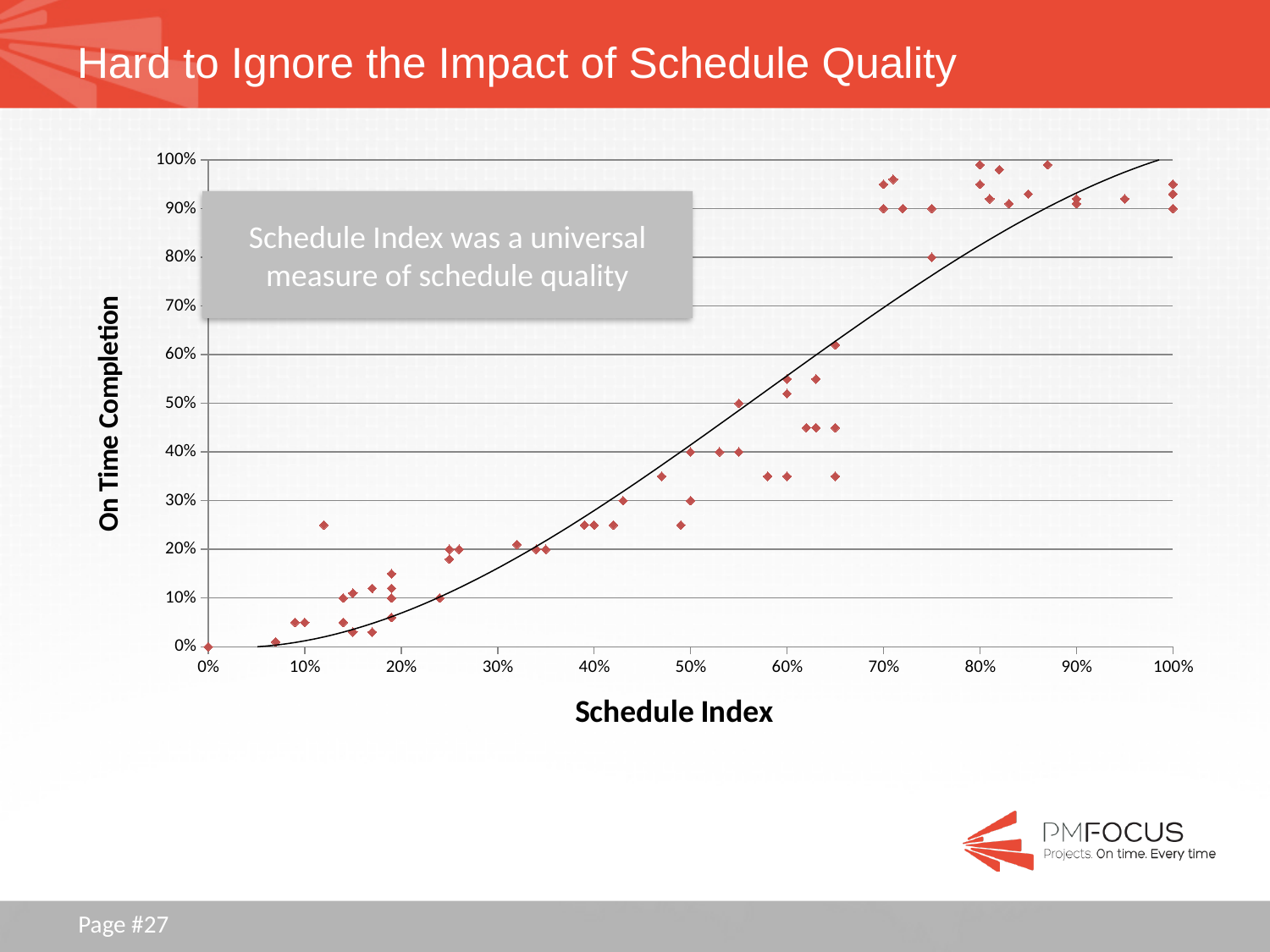
What is the highest value shown on the y axis of the chart? 100% Is the trend line's On Time Completion value at a Schedule Index of 30% greater or less than 40%? less Is the trend line's On Time Completion value at a Schedule Index of 50% greater or less than 30%? greater Do the On Time Completion values generally rise or fall as the Schedule Index increases along the x axis? rise Is the trend line's On Time Completion value at a Schedule Index of 20% greater or less than 20%? less What is the title of the y axis of the chart? On Time Completion What is the title of the x axis of the chart? Schedule Index What kind of chart is shown on the slide? scatter chart